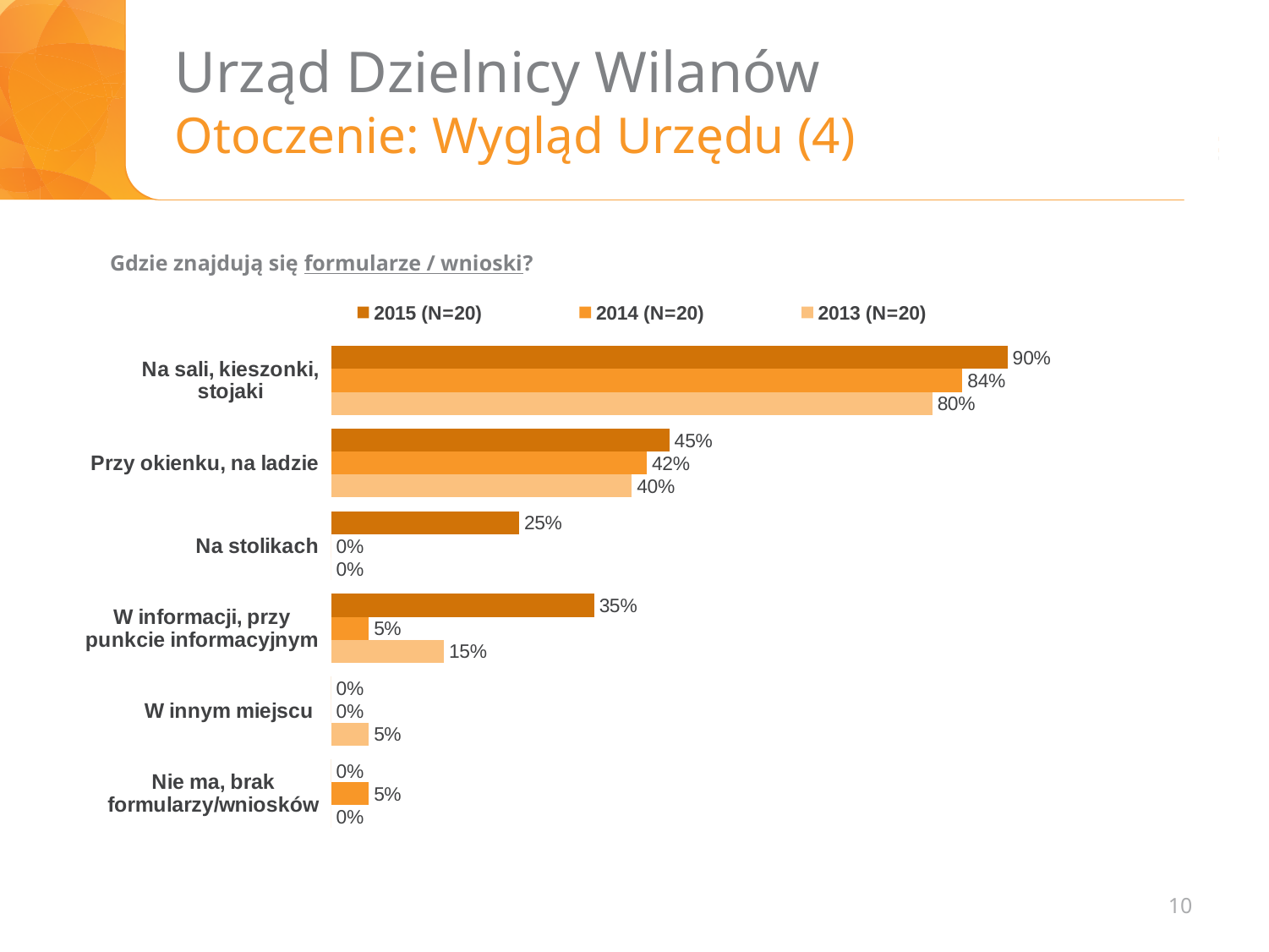
What question does the chart answer, as stated above it? Gdzie znajdują się formularze / wnioski? Which category has the highest value in the 2015 (N=20) series? Na sali, kieszonki, stojaki What is the value for "Przy okienku, na ladzie" in the 2014 (N=20) series? 42% What is the value for "Na stolikach" in the 2015 (N=20) series? 25% What is the difference between the 2015 (N=20) and 2013 (N=20) values for "Na sali, kieszonki, stojaki"? 10% What kind of chart is shown on the slide? Bar chart What is the value for "Na sali, kieszonki, stojaki" in the 2015 (N=20) series? 90% What is the value for "W informacji, przy punkcie informacyjnym" in the 2013 (N=20) series? 15% How many series does the legend list? 3 Which is larger for "Przy okienku, na ladzie": the 2015 (N=20) value or the 2013 (N=20) value? 2015 (N=20) What is the difference between the 2015 (N=20) and 2014 (N=20) values for "W informacji, przy punkcie informacyjnym"? 30% How many categories are shown on the chart? 6